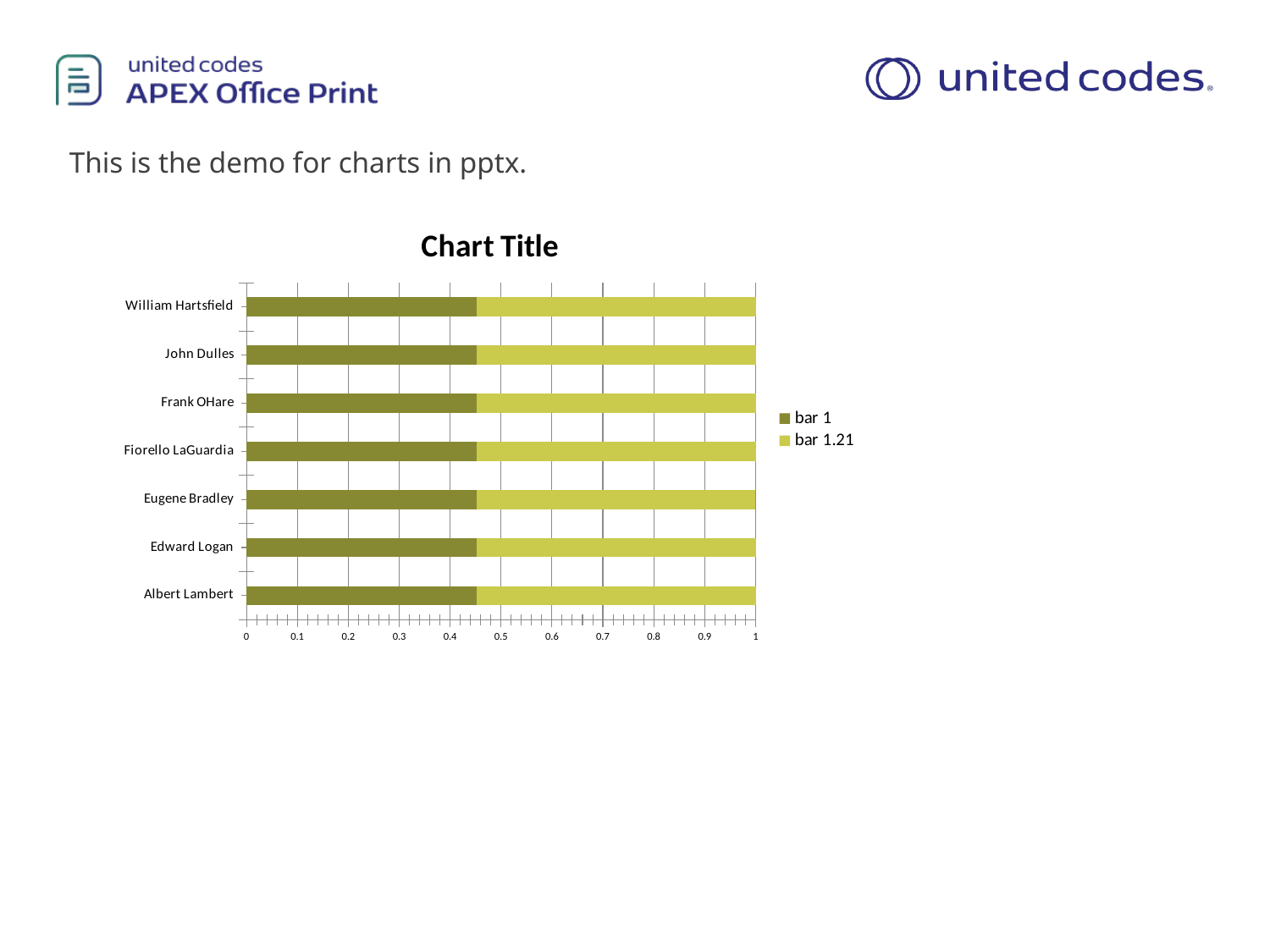
Is the 'bar 1' value for Albert Lambert greater or less than 0.4? greater Is the 'bar 1' value for John Dulles greater or less than 0.6? less What kind of chart is shown on the slide? bar chart What is the title of the chart? Chart Title Which category is listed at the top of the chart's vertical axis? William Hartsfield What is the total of the stacked bar for Edward Logan? 1 What is the total of the stacked bar for Fiorello LaGuardia? 1 For Frank OHare, which segment is larger, 'bar 1' or 'bar 1.21'? bar 1.21 Is the 'bar 1' value for William Hartsfield greater or less than 0.5? less How many series does the chart's legend list? 2 What are the two series names shown in the legend? bar 1 and bar 1.21 How many categories are plotted on the chart? 7